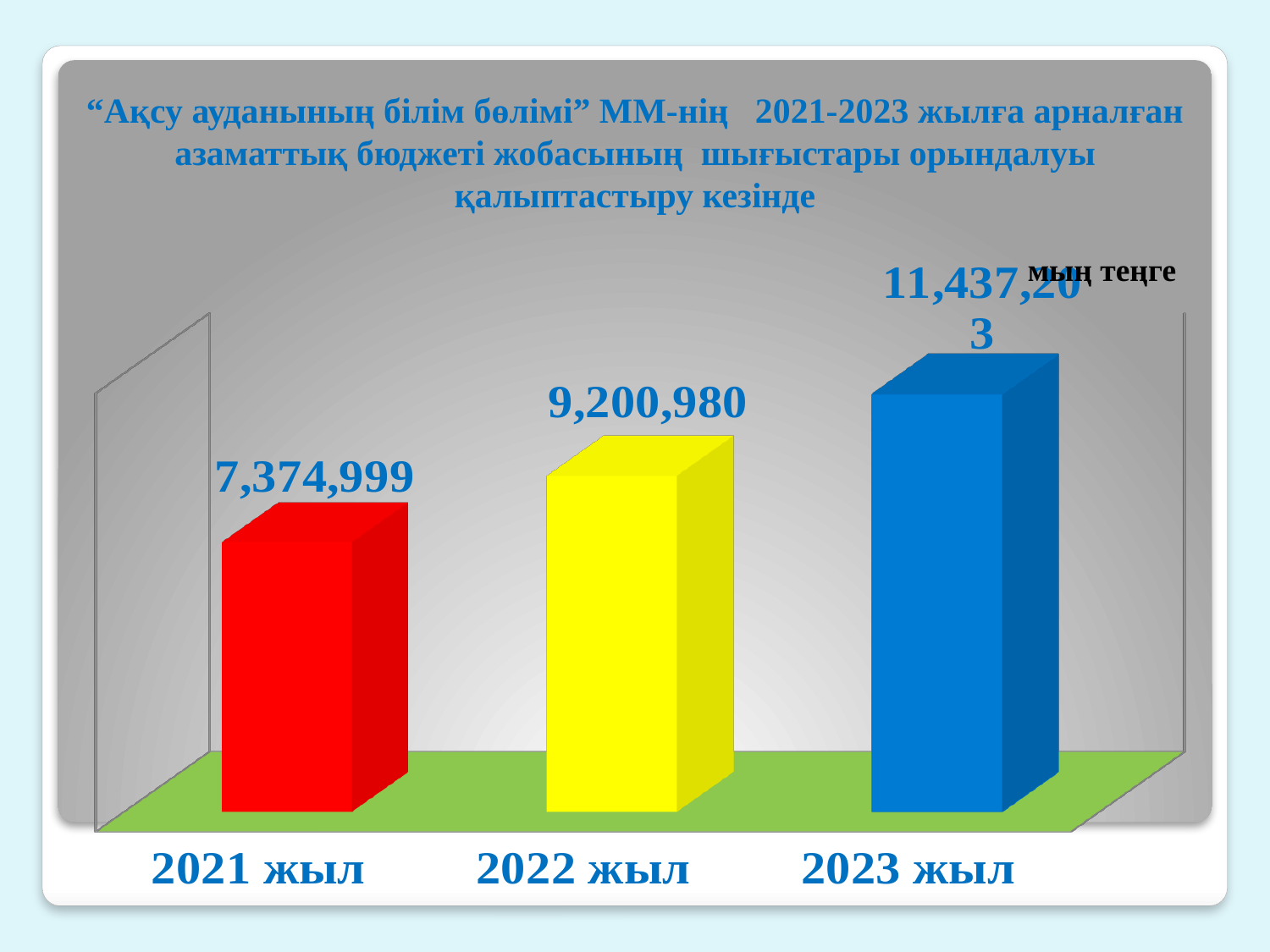
Which year has the lowest value? 2021 жыл What is the difference between the values for 2022 жыл and 2021 жыл? 1,825,981 What colour is the bar for 2022 жыл? Yellow What unit is indicated at the top right of the chart? мың теңге Which year has the highest value? 2023 жыл How many bars are shown in the chart? 3 What kind of chart is shown on the slide? Bar chart What is the value for 2021 жыл? 7,374,999 What is the value for 2022 жыл? 9,200,980 What is the value for 2023 жыл? 11,437,203 Do the values rise or fall from 2021 жыл to 2023 жыл? Rise Which is larger, the value for 2022 жыл or 2021 жыл? 2022 жыл